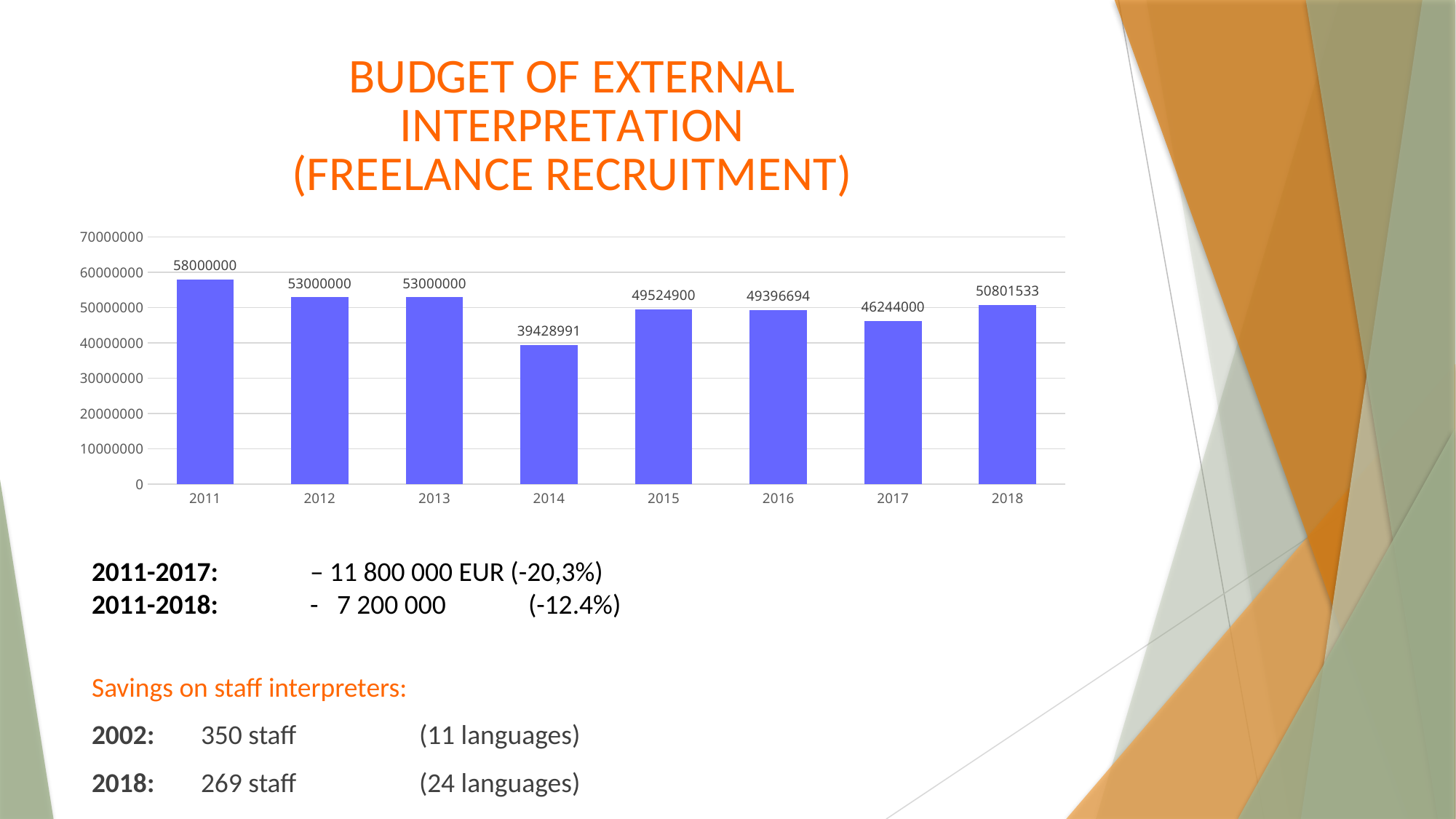
How many years are shown on the x axis? 8 Is the value for 2014 greater or less than 40000000? less What kind of chart is shown on the slide? bar chart What is the value for 2011? 58000000 What is the difference between the values for 2011 and 2017? 11756000 What is the value for 2018? 50801533 Which is larger, the value for 2012 or the value for 2014? 2012 Which year has the highest value? 2011 Which year has the lowest value? 2014 What is the value for 2014? 39428991 What is the difference between the values for 2018 and 2017? 4557533 What is the value for 2017? 46244000